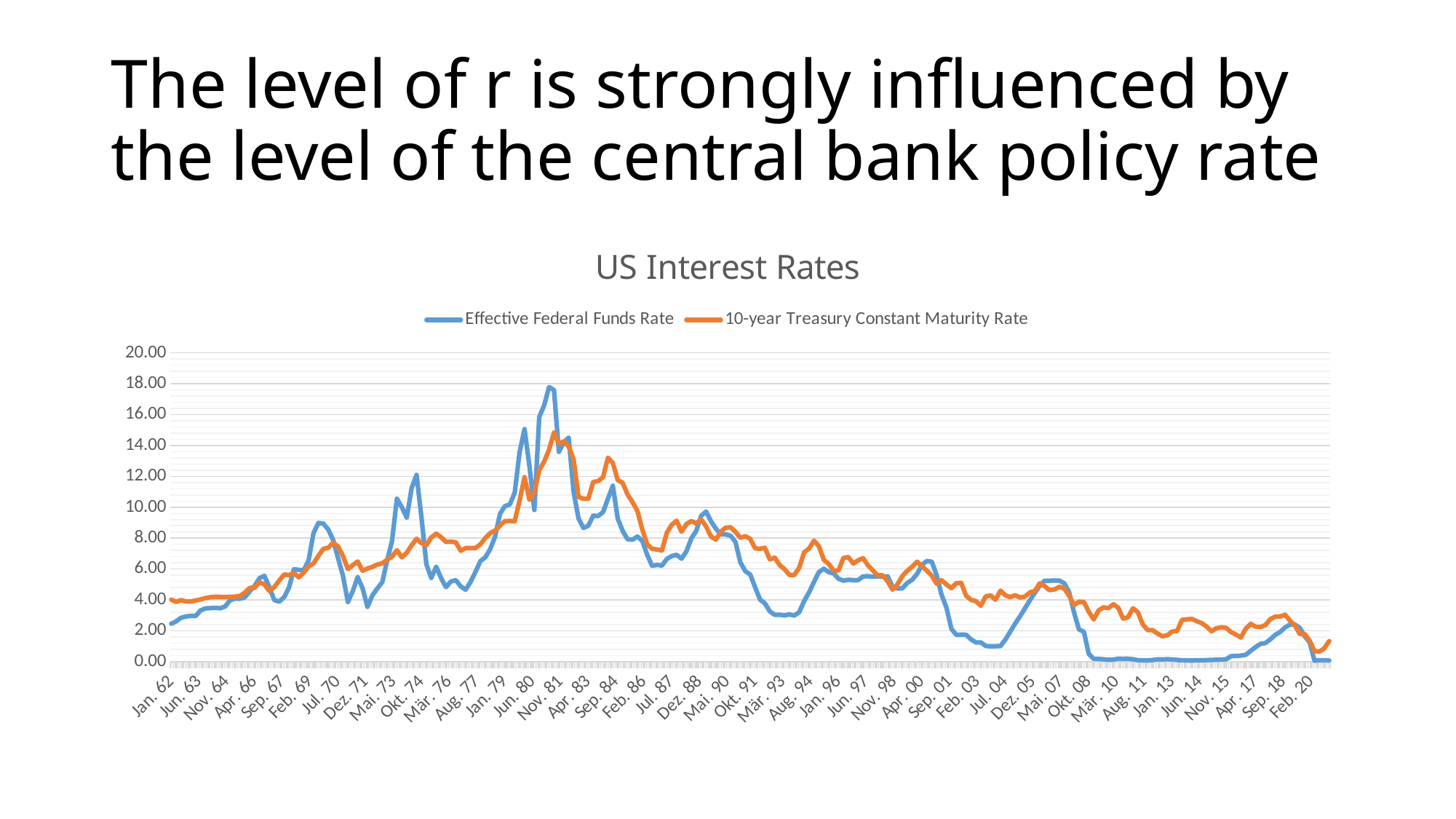
Which colour is used for the 10-year Treasury Constant Maturity Rate line? orange Is the peak value of the Effective Federal Funds Rate around Nov. 81 greater or less than 16.00? greater What kind of chart is shown under the title "US Interest Rates"? line chart Which series reaches the highest value anywhere on the chart? Effective Federal Funds Rate How many series does the legend of the "US Interest Rates" chart list? 2 Around Mär. 10, which series is higher: the Effective Federal Funds Rate or the 10-year Treasury Constant Maturity Rate? 10-year Treasury Constant Maturity Rate What is the highest value shown on the vertical axis of the chart? 20.00 Overall, do the interest rates rise or fall from Nov. 81 to Feb. 20? fall What are the two series named in the legend of the "US Interest Rates" chart? Effective Federal Funds Rate and 10-year Treasury Constant Maturity Rate Is the peak value of the 10-year Treasury Constant Maturity Rate greater or less than 16.00? less Is the Effective Federal Funds Rate around Mär. 10 greater or less than 2.00? less